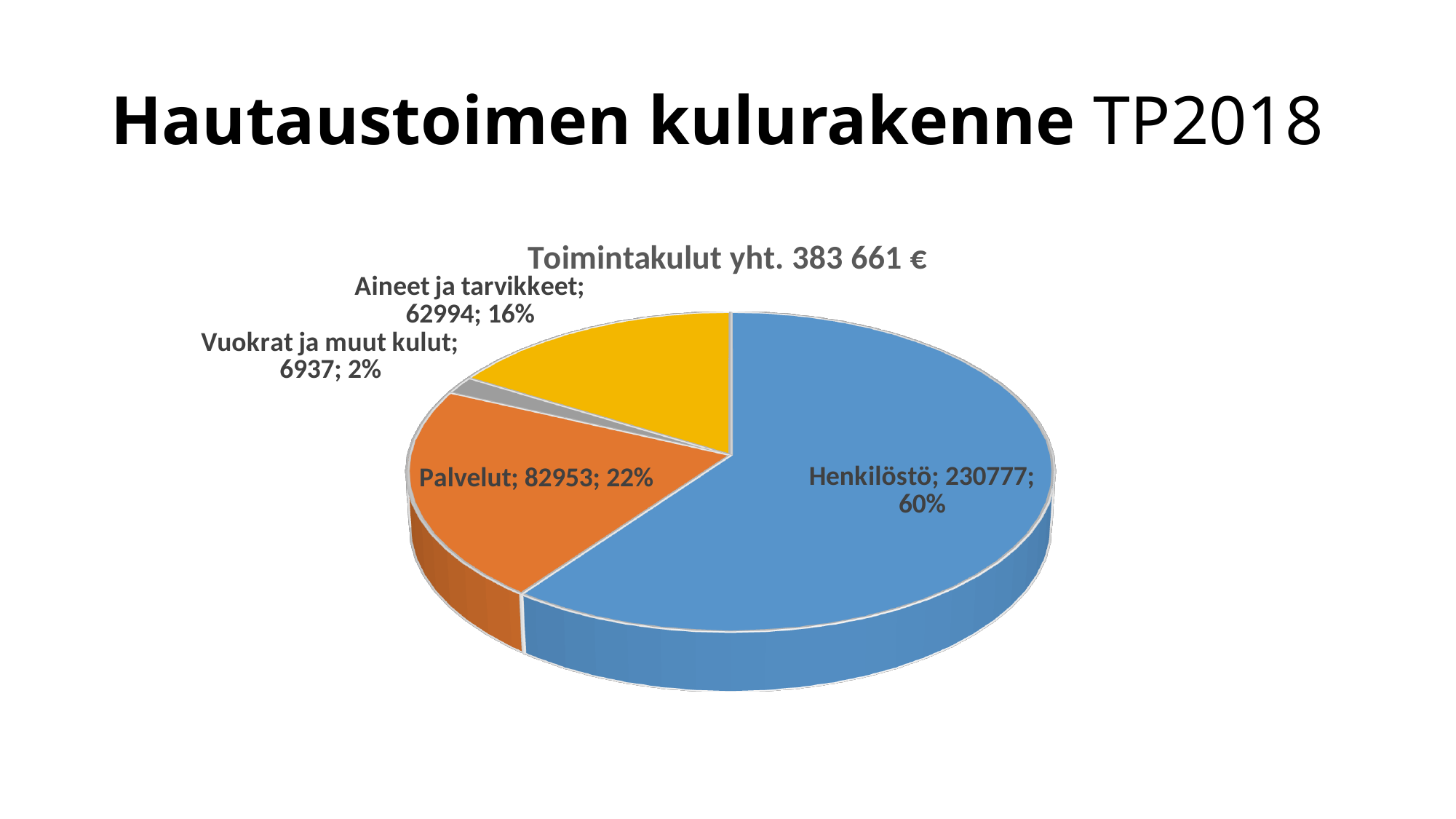
What is the value for Aineet ja tarvikkeet? 62994 What is the value for Palvelut? 82953 What is the value for Henkilöstö? 230777 What is the difference between the values for Palvelut and Aineet ja tarvikkeet? 19959 Which category has the largest slice? Henkilöstö How many slices does the pie chart have? 4 What is the value for Vuokrat ja muut kulut? 6937 Which is larger, the value for Henkilöstö or the value for Palvelut? Henkilöstö What share of the pie does Aineet ja tarvikkeet represent? 16% What share of the pie does Palvelut represent? 22% What is the title of the chart? Toimintakulut yht. 383 661 € Which category has the smallest slice? Vuokrat ja muut kulut